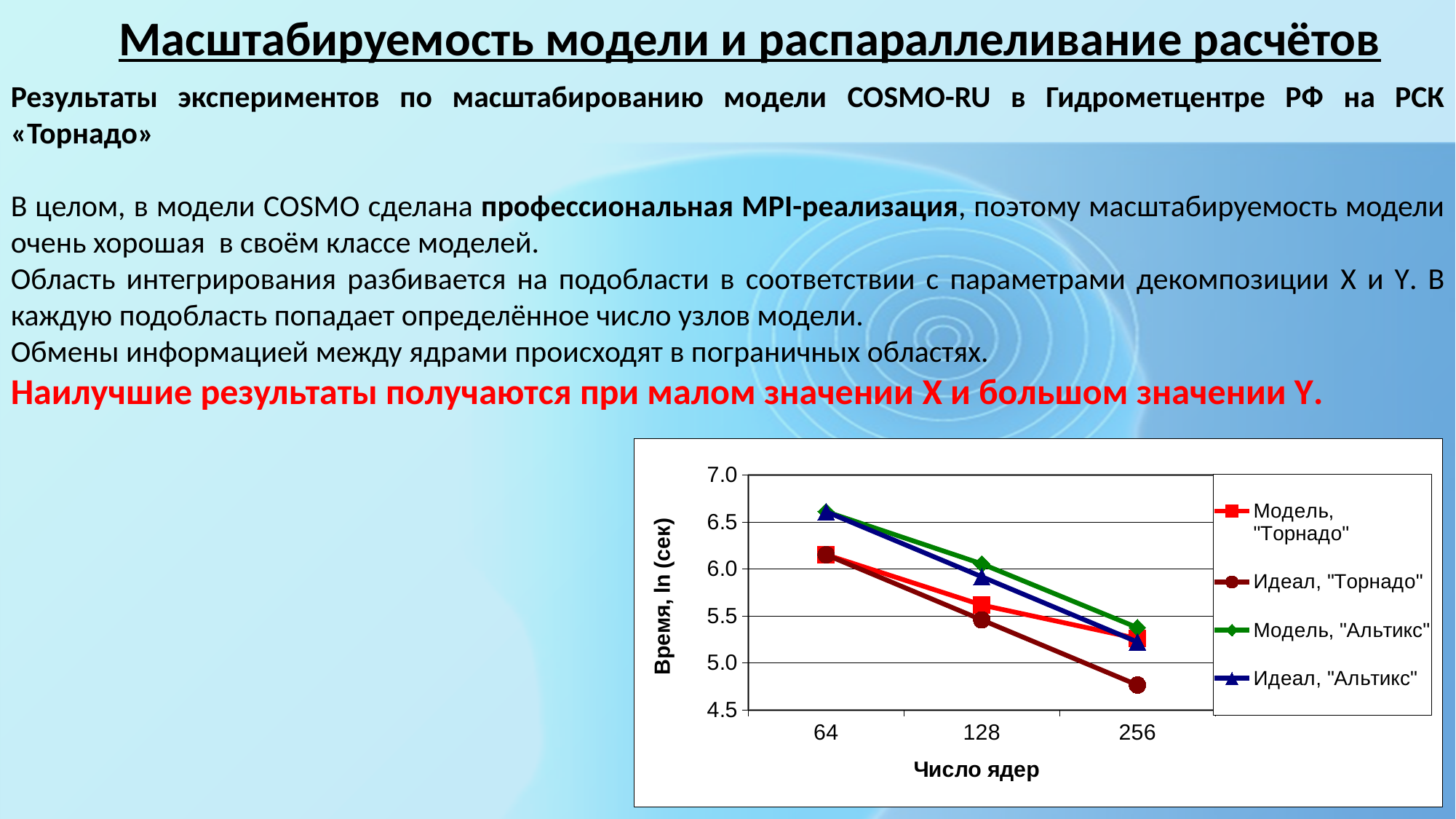
What is the label of the x axis of the chart? Число ядер Which series has the lowest value at 256 cores? Идеал, "Торнадо" Is the value for Модель, "Торнадо" at 64 cores greater or less than 6.5? less At 64 cores, which is larger: the value for Модель, "Альтикс" or the value for Модель, "Торнадо"? Модель, "Альтикс" Is the value for Идеал, "Торнадо" at 256 cores greater or less than 5.0? less Does the value for Идеал, "Торнадо" rise or fall as the number of cores increases from 64 to 256? fall How many values of the number of cores (Число ядер) are plotted on the x axis? 3 How many series does the chart legend list? 4 What is the label of the y axis of the chart? Время, ln (сек) Is the value for Идеал, "Альтикс" at 256 cores greater or less than 5.0? greater What kind of chart is shown on the slide? line chart